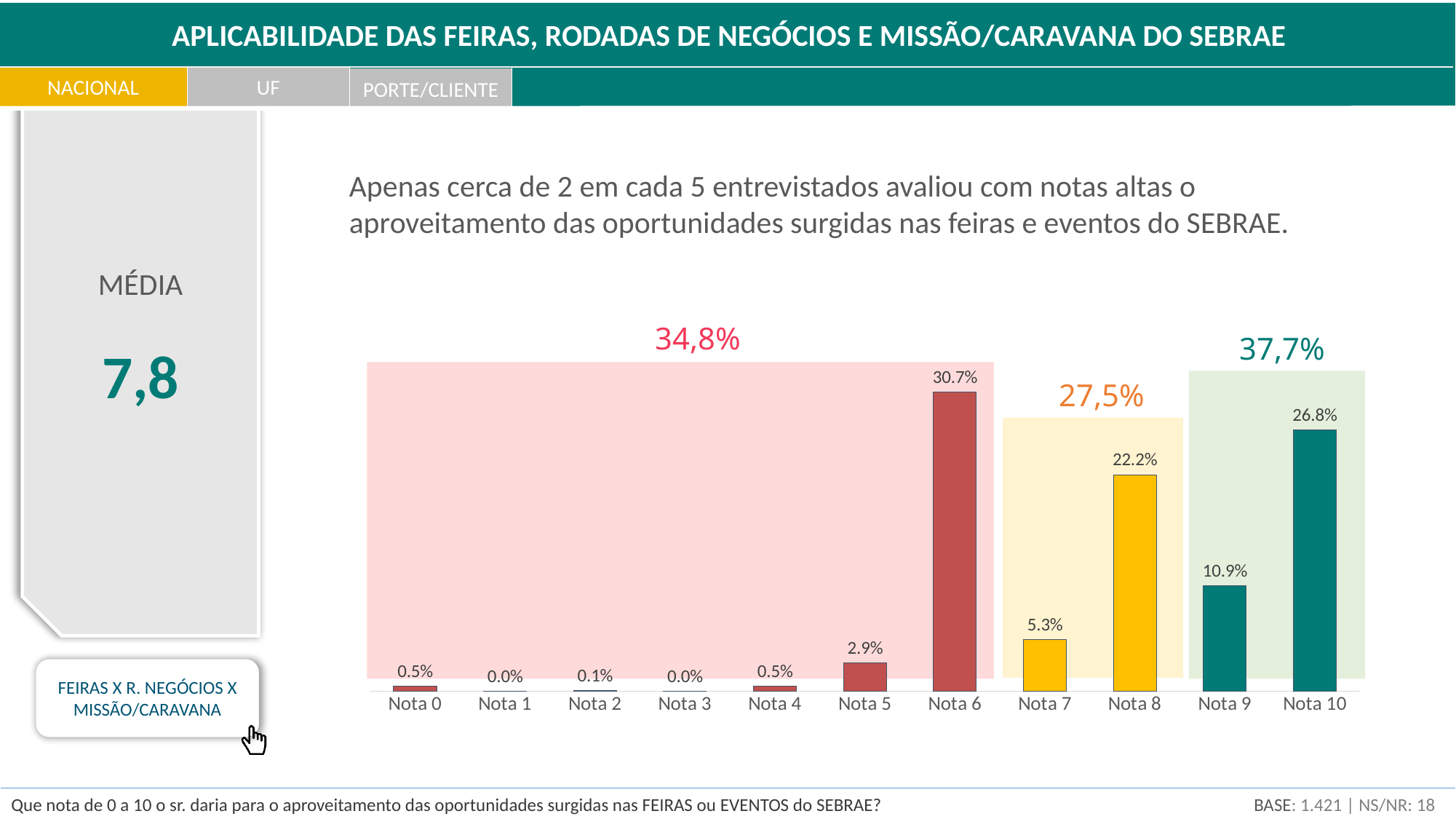
What is the value for Nota 10? 26.8% What is the value for Nota 7? 5.3% What is the combined share shown for the group Nota 0 to Nota 6? 34,8% What kind of chart is shown on the slide? Bar chart How many categories (Nota 0 to Nota 10) are shown on the x axis? 11 What is the value for Nota 6? 30.7% What is the combined share shown for the group Nota 9 and Nota 10? 37,7% What is the difference between the values for Nota 8 and Nota 7? 16.9% Which is larger, the value for Nota 10 or the value for Nota 8? Nota 10 Which category has the highest value? Nota 6 What is the value for Nota 9? 10.9% What is the MÉDIA (average) shown on the left of the slide? 7,8